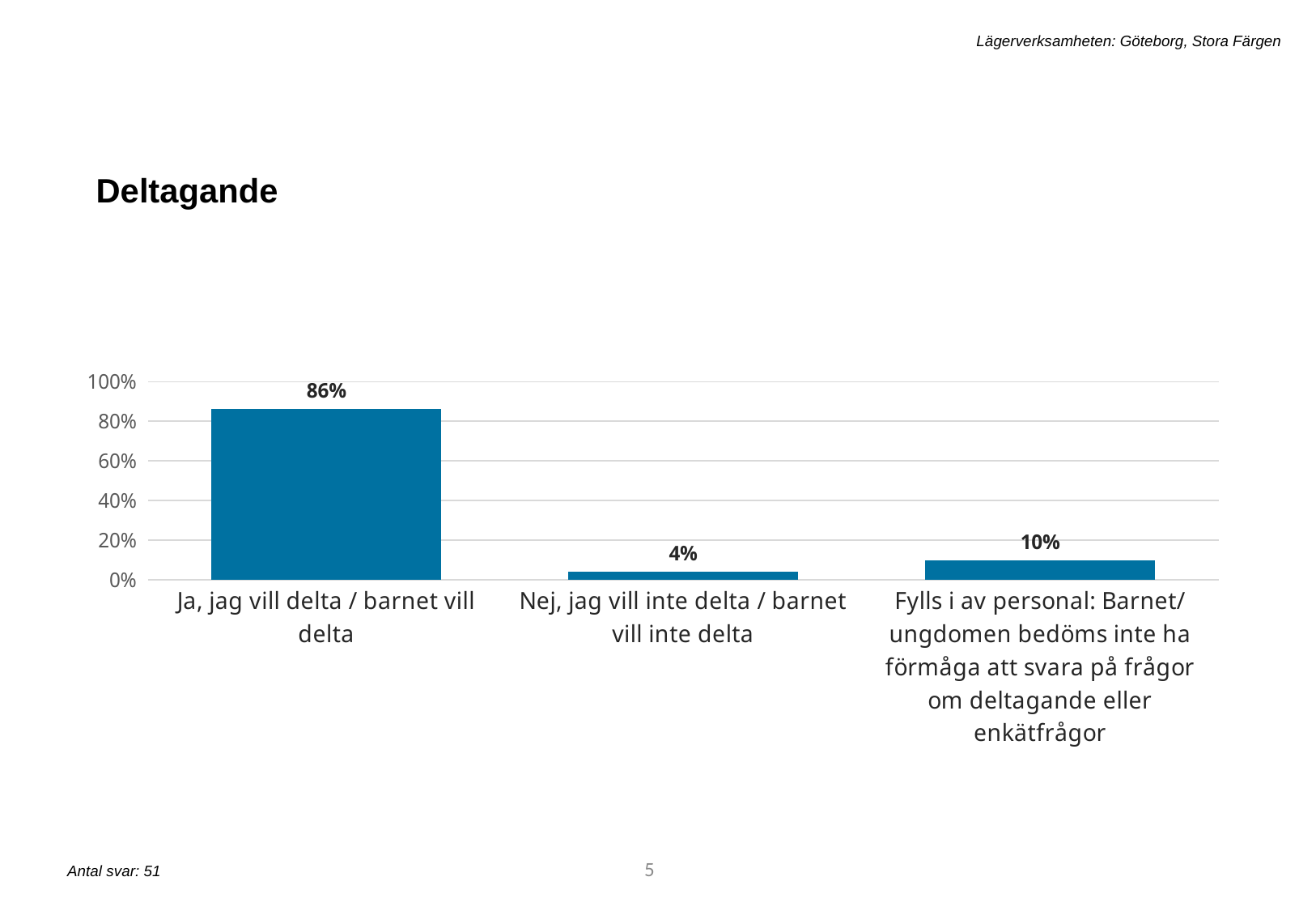
Which category has the lowest value? Nej, jag vill inte delta / barnet vill inte delta What is the title of the chart? Deltagande Is the value for "Ja, jag vill delta / barnet vill delta" greater or less than 80%? greater What is the value for "Nej, jag vill inte delta / barnet vill inte delta"? 4% What is the value for the category "Fylls i av personal: Barnet/ ungdomen bedöms inte ha förmåga att svara på frågor om deltagande eller enkätfrågor"? 10% Which is larger: the value for "Nej, jag vill inte delta / barnet vill inte delta" or the value for "Fylls i av personal"? Fylls i av personal What is the difference between the values for "Fylls i av personal" and "Nej, jag vill inte delta / barnet vill inte delta"? 6% Which category has the highest value? Ja, jag vill delta / barnet vill delta What is the difference between the values for "Ja, jag vill delta / barnet vill delta" and "Nej, jag vill inte delta / barnet vill inte delta"? 82% How many categories are shown in the chart? 3 What kind of chart is shown on the slide? Bar chart What is the value for "Ja, jag vill delta / barnet vill delta"? 86%